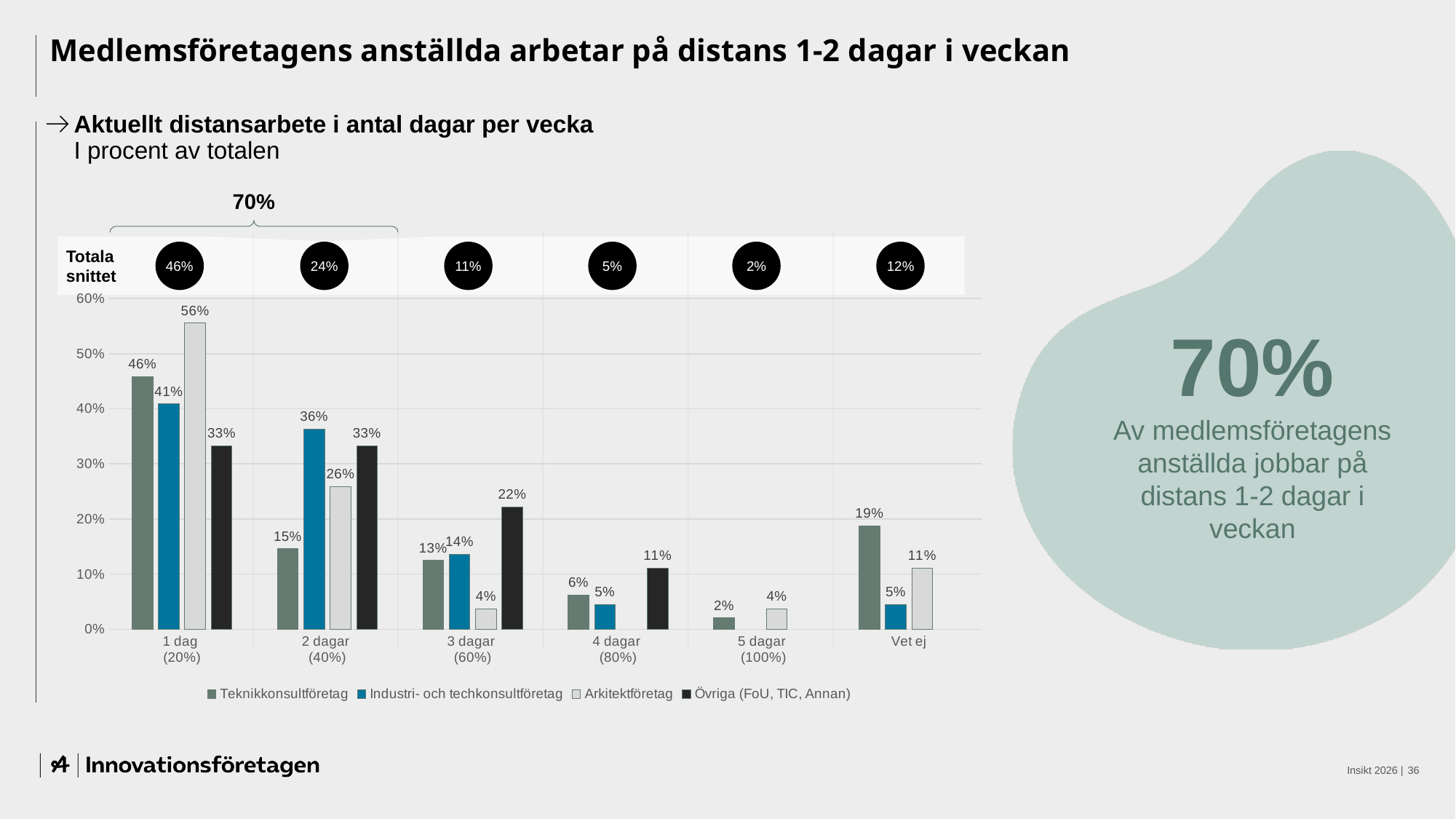
What type of chart is shown on the slide? Bar chart What is the 'Totala snittet' value shown for '2 dagar (40%)'? 24% Which is larger in the '2 dagar (40%)' category: Teknikkonsultföretag or Övriga (FoU, TIC, Annan)? Övriga (FoU, TIC, Annan) What percentage is highlighted in the large text on the right side of the slide? 70% How many categories are shown on the x axis? 6 Which series has the highest value in the '1 dag (20%)' category? Arkitektföretag What is the difference between Teknikkonsultföretag and Arkitektföretag in the 'Vet ej' category? 8% What is the value for Övriga (FoU, TIC, Annan) in the '3 dagar (60%)' category? 22% What is the value for Arkitektföretag in the '1 dag (20%)' category? 56% What is the value for Industri- och techkonsultföretag in the '2 dagar (40%)' category? 36% Which series has the lowest value in the '3 dagar (60%)' category? Arkitektföretag How many series does the legend list? 4